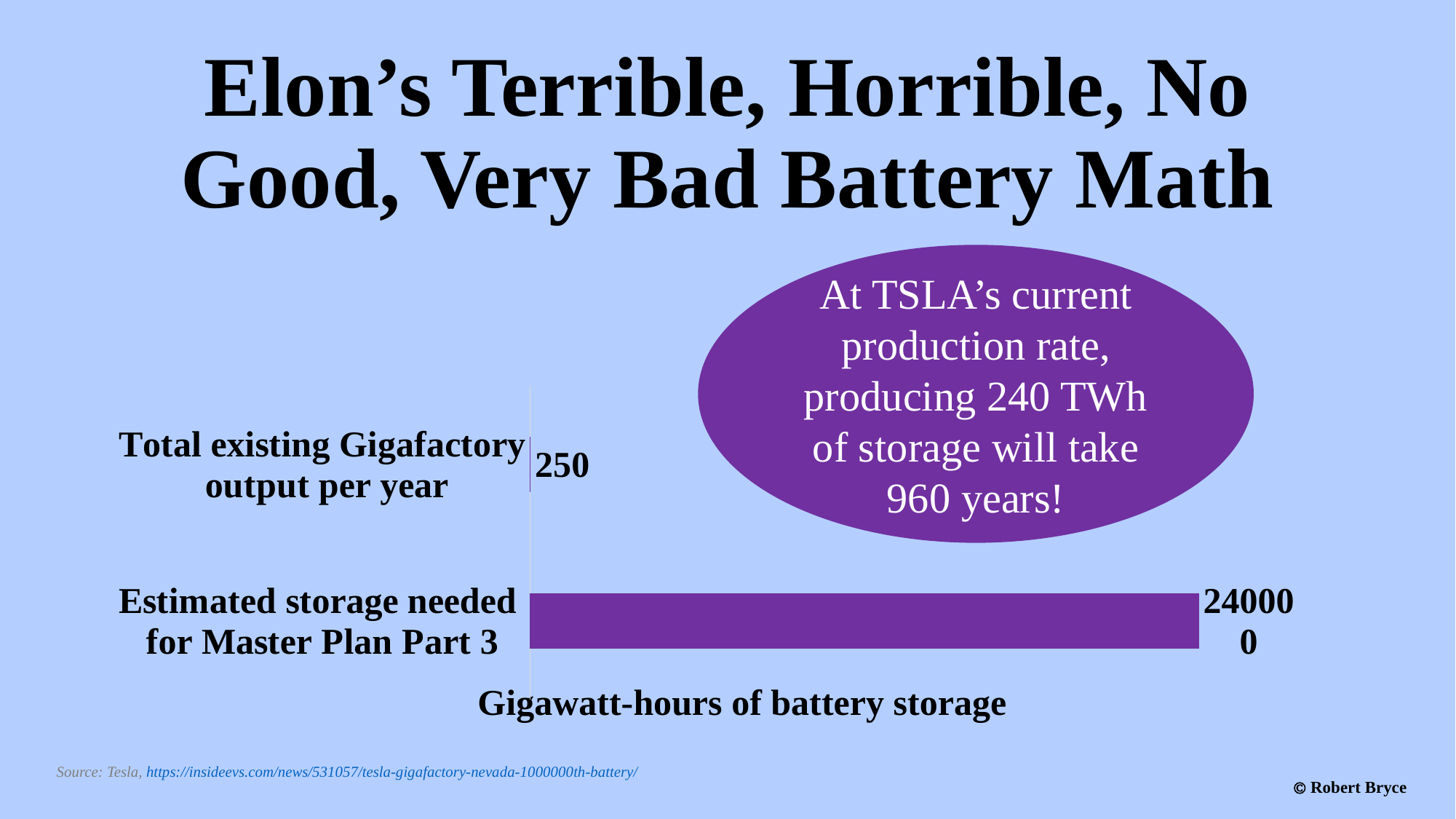
What is the value for Total existing Gigafactory output per year? 250 How many categories are shown in the chart? 2 What is the axis title shown below the bars? Gigawatt-hours of battery storage Which category has the lowest value? Total existing Gigafactory output per year Which category has the highest value? Estimated storage needed for Master Plan Part 3 What is the value for Estimated storage needed for Master Plan Part 3? 240000 What kind of chart is shown on the slide? Bar chart Which is larger: Total existing Gigafactory output per year or Estimated storage needed for Master Plan Part 3? Estimated storage needed for Master Plan Part 3 What colour are the bars in the chart? Purple What is the difference between the Estimated storage needed for Master Plan Part 3 and the Total existing Gigafactory output per year? 239750